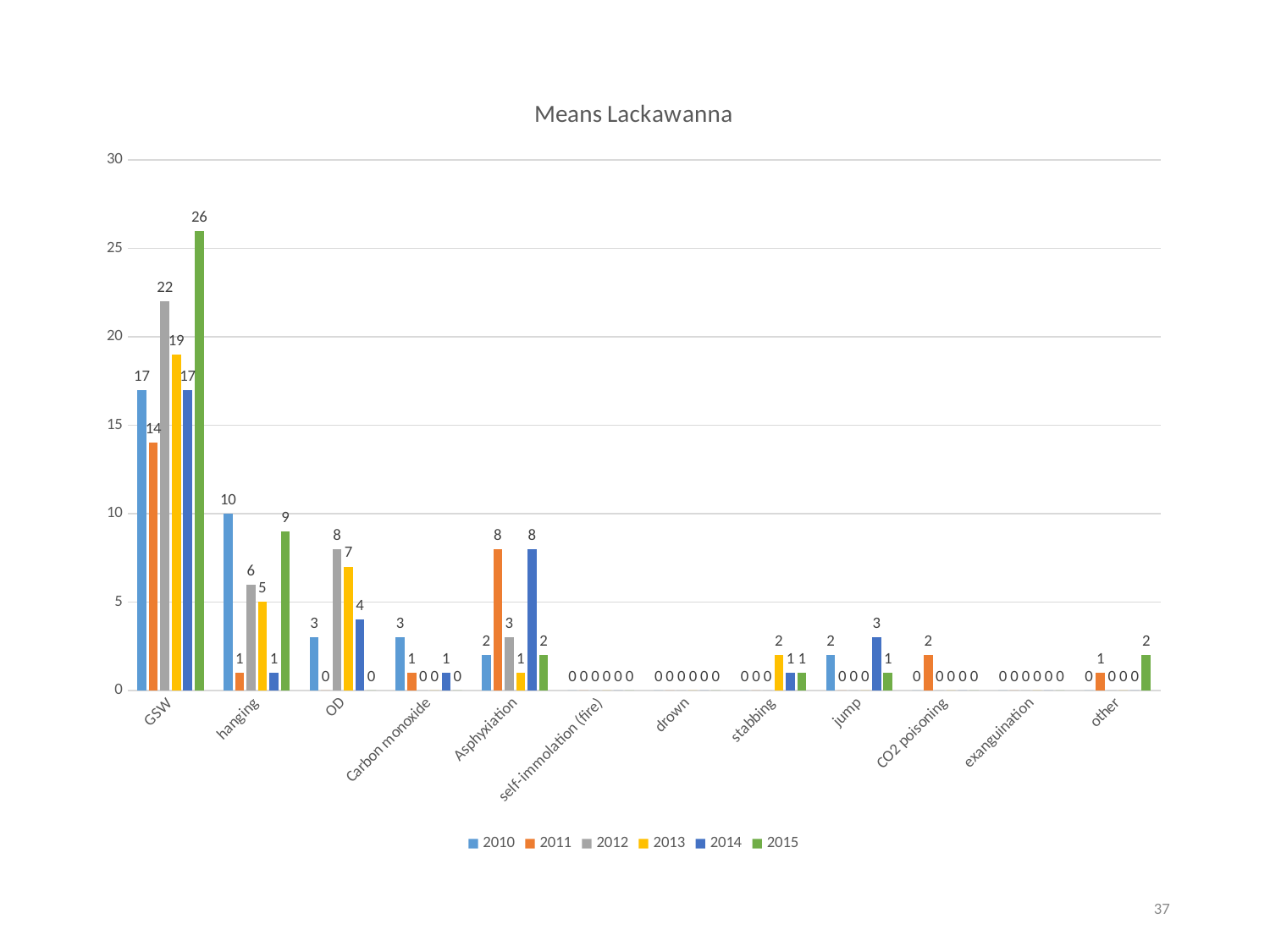
What is the value for hanging in 2010? 10 What is the value for Asphyxiation in 2011? 8 What is the difference between the 2012 and 2011 values for GSW? 8 What is the value for OD in 2012? 8 Which is larger for hanging: the 2012 value or the 2013 value? 2012 How many series does the legend list? 6 What kind of chart is shown on the slide? bar chart Which year has the lowest value for GSW? 2011 Which year has the highest value for GSW? 2015 What is the title of the chart? Means Lackawanna How many categories are shown on the x axis? 12 What is the value for GSW in 2015? 26